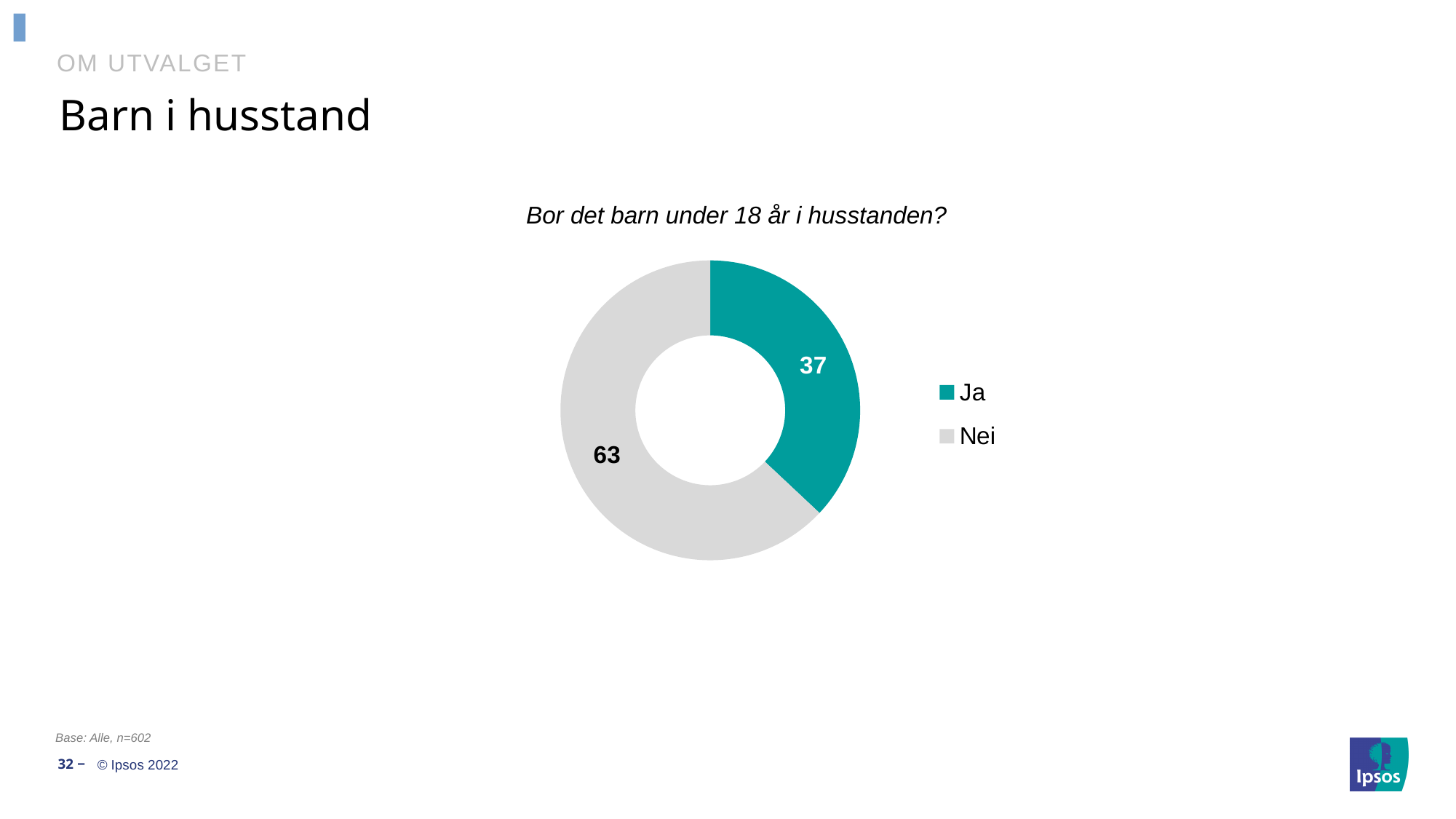
What question is the chart titled with? Bor det barn under 18 år i husstanden? How many categories does the chart show? 2 Which colour represents "Ja" in the chart? Teal Which category has the largest slice in the chart? Nei What value is shown for "Ja" in the chart? 37 What kind of chart is shown on the slide? Doughnut (pie) chart Which is larger, the value for "Ja" or the value for "Nei"? Nei What value is shown for "Nei" in the chart? 63 What is the difference between the values for "Nei" and "Ja"? 26 What is the total of the two values shown in the chart? 100 Which category has the smallest slice in the chart? Ja